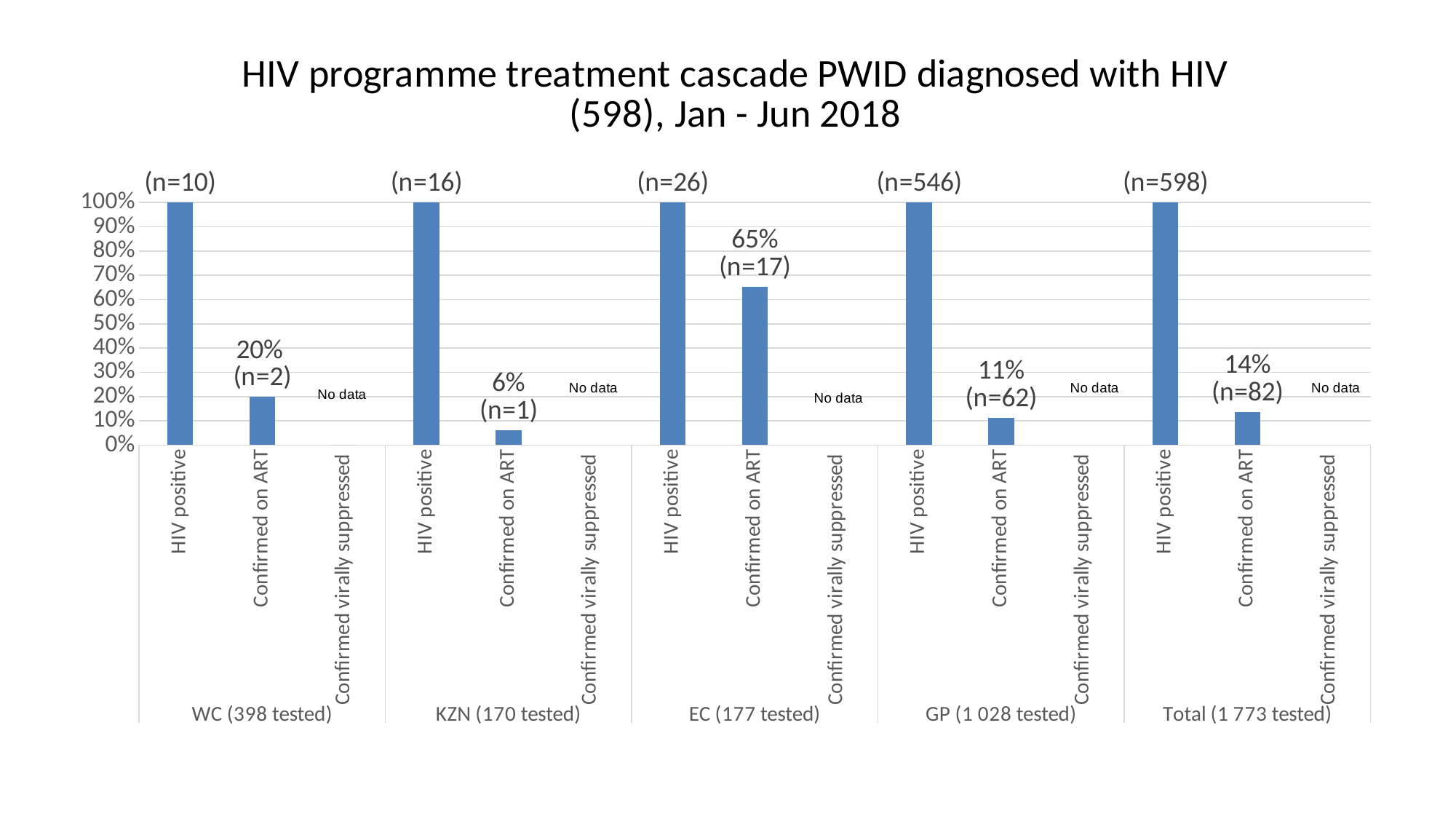
What is the n value shown above the HIV positive bar for WC? 10 What is the difference in percentage points between the confirmed on ART value for EC and for WC? 45 Which province has the highest percentage confirmed on ART? EC How many province/total groups are shown on the x axis? 5 What percentage of HIV-positive PWID in EC were confirmed on ART? 65% How many HIV-positive PWID were confirmed on ART in GP (the n value)? 62 Is the confirmed on ART value for Total greater or less than 20%? less Which province has the lowest percentage confirmed on ART? KZN What type of chart is shown on the slide? Bar chart What is shown for the 'Confirmed virally suppressed' category in every group? No data Is the confirmed on ART percentage higher for WC or for GP? WC What percentage of HIV-positive PWID in KZN were confirmed on ART? 6%